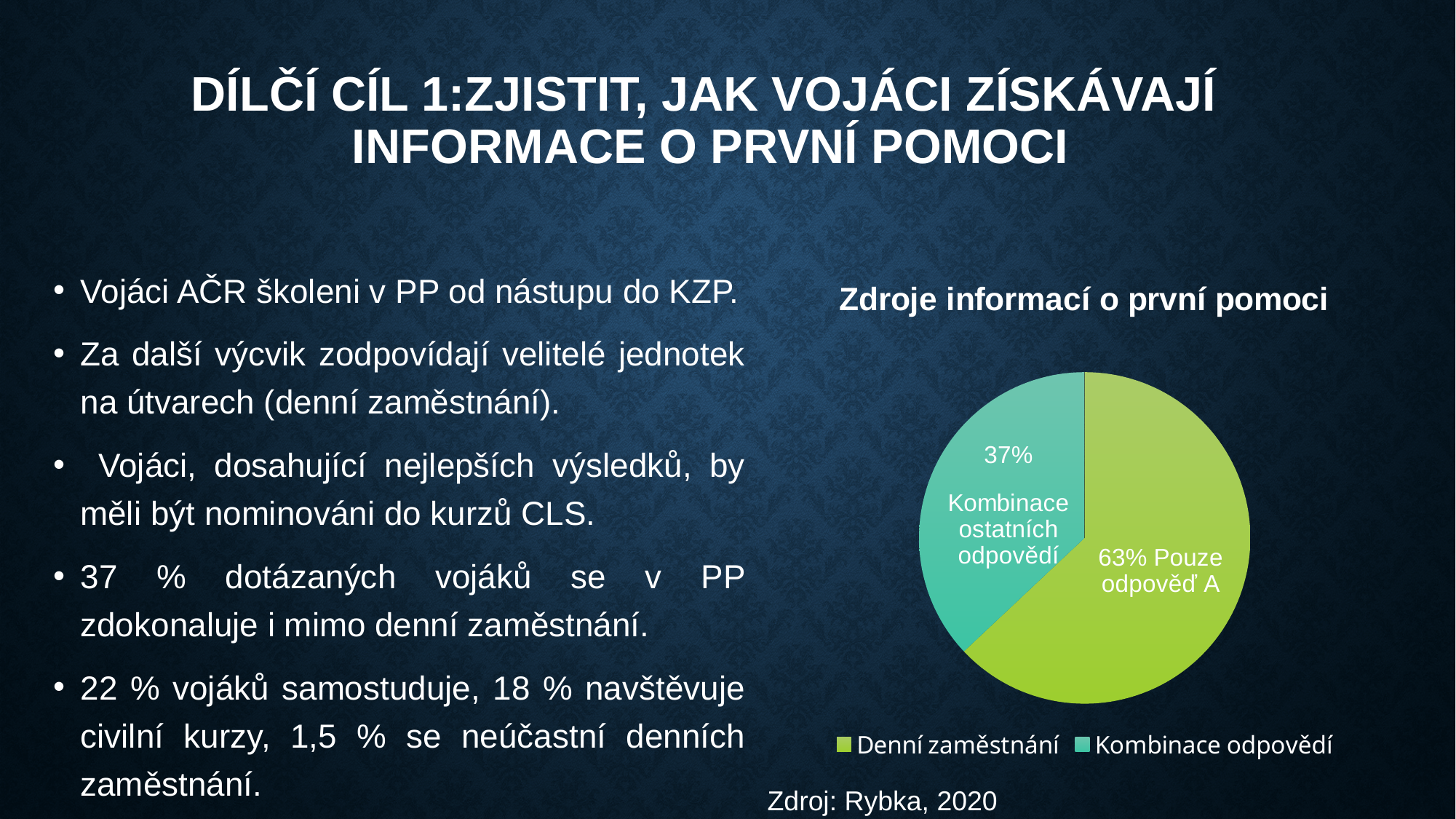
Which is larger: the 'Denní zaměstnání' slice or the 'Kombinace odpovědí' slice? Denní zaměstnání How many slices does the pie chart have? 2 What is the difference in percentage points between the 'Denní zaměstnání' slice and the 'Kombinace odpovědí' slice? 26 Which slice of the pie is the smallest? Kombinace odpovědí What kind of chart is shown on the slide? pie chart How many entries does the legend list? 2 What percentage does the 'Denní zaměstnání' slice show? 63% What is the title of the chart? Zdroje informací o první pomoci Which slice of the pie is the largest? Denní zaměstnání What percentage does the 'Kombinace odpovědí' slice show? 37% What share of the pie does the 'Kombinace odpovědí' slice represent? 37% What label is printed inside the 63% slice? 63% Pouze odpověď A